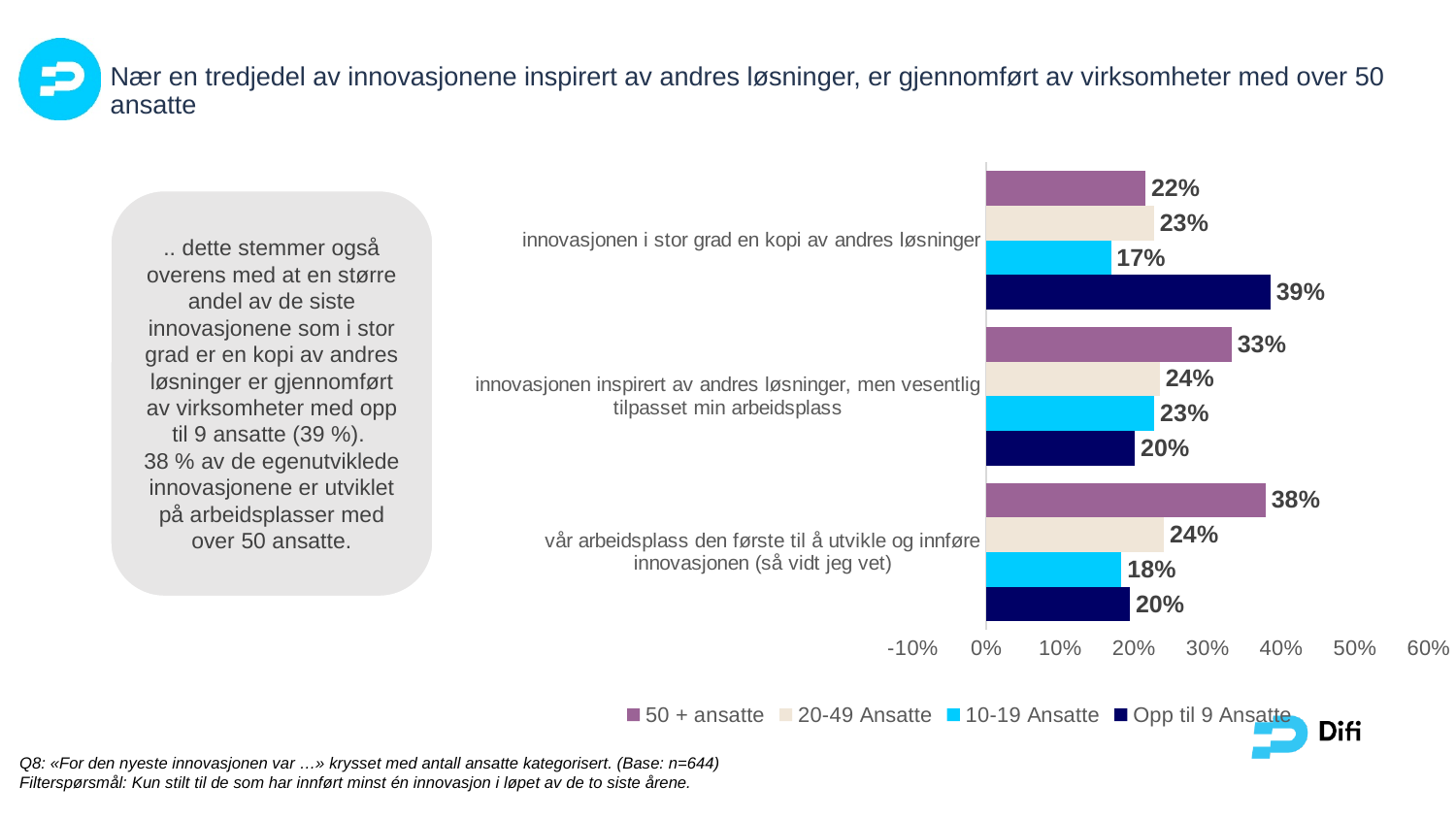
Which series has the highest value in the category 'innovasjonen i stor grad en kopi av andres løsninger'? Opp til 9 Ansatte Which series has the lowest value in the category 'vår arbeidsplass den første til å utvikle og innføre innovasjonen (så vidt jeg vet)'? 10-19 Ansatte How many series does the legend list? 4 What is the value for 'Opp til 9 Ansatte' in the category 'innovasjonen i stor grad en kopi av andres løsninger'? 39% What kind of chart is shown on the slide? bar chart What is the difference between the '50 + ansatte' value and the '20-49 Ansatte' value in the category 'vår arbeidsplass den første til å utvikle og innføre innovasjonen (så vidt jeg vet)'? 14% What is the value for '50 + ansatte' in the category 'vår arbeidsplass den første til å utvikle og innføre innovasjonen (så vidt jeg vet)'? 38% What is the value for '10-19 Ansatte' in the category 'innovasjonen inspirert av andres løsninger, men vesentlig tilpasset min arbeidsplass'? 23% Which is larger in the category 'innovasjonen inspirert av andres løsninger, men vesentlig tilpasset min arbeidsplass': the value for '50 + ansatte' or the value for 'Opp til 9 Ansatte'? 50 + ansatte Which legend entry is shown in dark navy blue? Opp til 9 Ansatte What is the difference between the 'Opp til 9 Ansatte' value and the '10-19 Ansatte' value in the category 'innovasjonen i stor grad en kopi av andres løsninger'? 22% How many categories are shown on the chart? 3